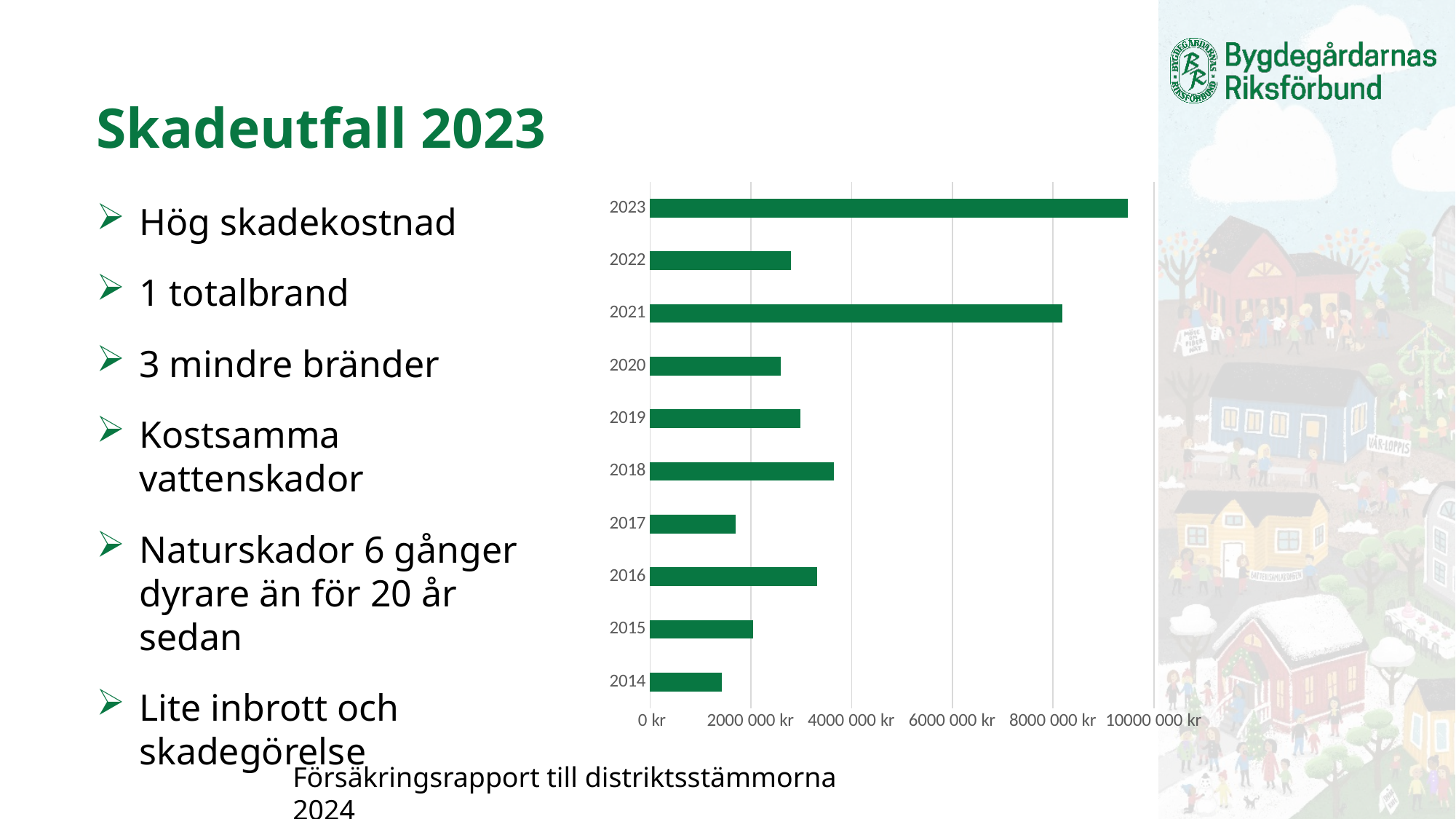
Is the value for 2018 greater or less than 4000 000 kr? less Which year has the highest value in the chart? 2023 How many years (bars) are shown in the chart? 10 Is the value for 2014 greater or less than 2000 000 kr? less Which year has the larger value, 2023 or 2021? 2023 Is the value for 2021 greater or less than 8000 000 kr? greater What is the unit shown on the horizontal axis of the chart? kr Which year has the larger value, 2022 or 2014? 2022 Which year has the larger value, 2018 or 2017? 2018 Which year has the lowest value in the chart? 2014 What kind of chart is shown on the slide? bar chart